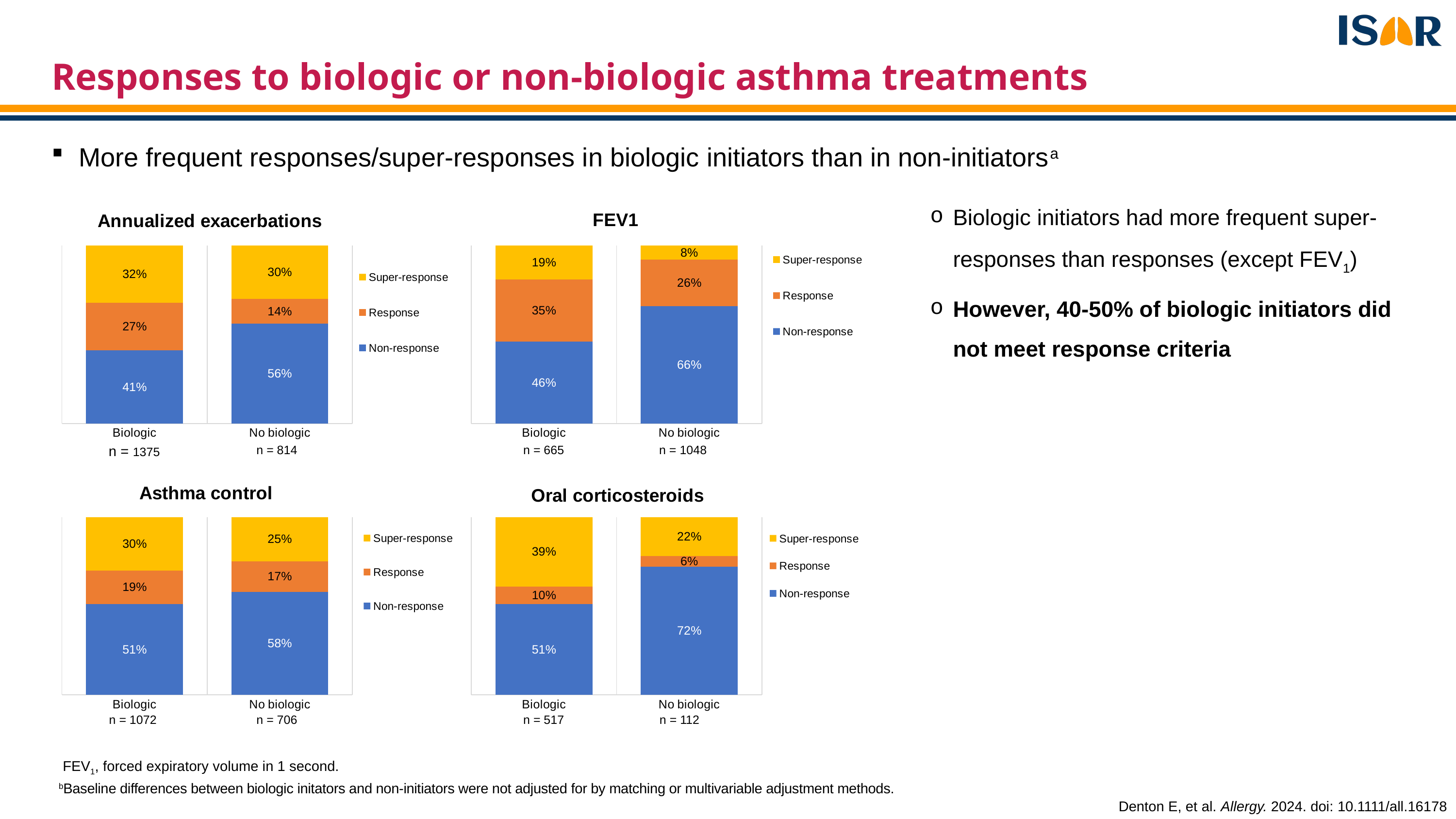
In the Oral corticosteroids chart, which group has the larger Super-response value, Biologic or No biologic? Biologic How many groups (bars) are shown in the Asthma control chart? 2 In the Oral corticosteroids chart, what is the Response value for the No biologic group? 6% In the FEV1 chart, what is the Super-response value for the No biologic group? 8% In the Asthma control chart, what is the difference between the Non-response values for No biologic and Biologic? 7% What kind of chart is the Oral corticosteroids chart? Stacked bar chart In the Annualized exacerbations chart, what is the Non-response value for the Biologic group? 41% How many series does the legend of the FEV1 chart list? 3 In the Asthma control chart, what is the Super-response value for the Biologic group? 30% In the Oral corticosteroids chart, what is the sample size (n) for the No biologic group? n = 112 In the FEV1 chart, which group has the larger Non-response value, Biologic or No biologic? No biologic In the Annualized exacerbations chart, what is the difference between the Response values for Biologic and No biologic? 13%